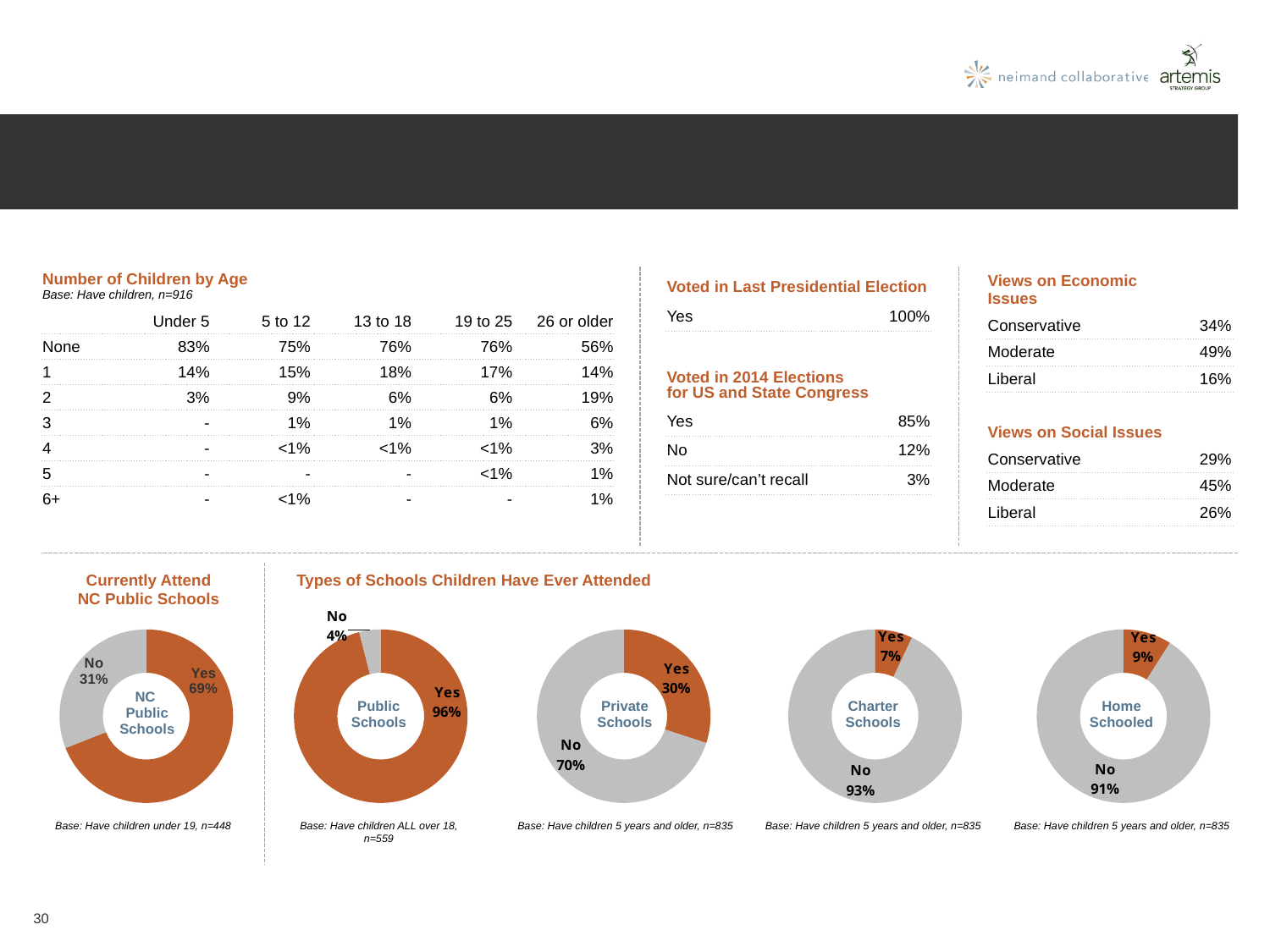
In the 'Charter Schools' donut chart, what percentage answered Yes? 7% What type of chart is used to show 'Types of Schools Children Have Ever Attended'? Donut (pie) chart In the 'Currently Attend NC Public Schools' donut chart, what is the difference between the Yes and No percentages? 38% In the 'Charter Schools' donut chart, how many slices are shown? 2 In the 'Public Schools' donut chart, what is the difference between the Yes and No percentages? 92% In the 'Home Schooled' donut chart, what percentage answered No? 91% In the 'Public Schools' donut chart, what percentage answered Yes? 96% In the 'Currently Attend NC Public Schools' donut chart, what percentage answered No? 31% In the 'Currently Attend NC Public Schools' donut chart, what percentage answered Yes? 69% In the 'Private Schools' donut chart, what percentage answered No? 70% In the 'Private Schools' donut chart, which slice is larger, Yes or No? No How many donut charts appear under the heading 'Types of Schools Children Have Ever Attended'? 4